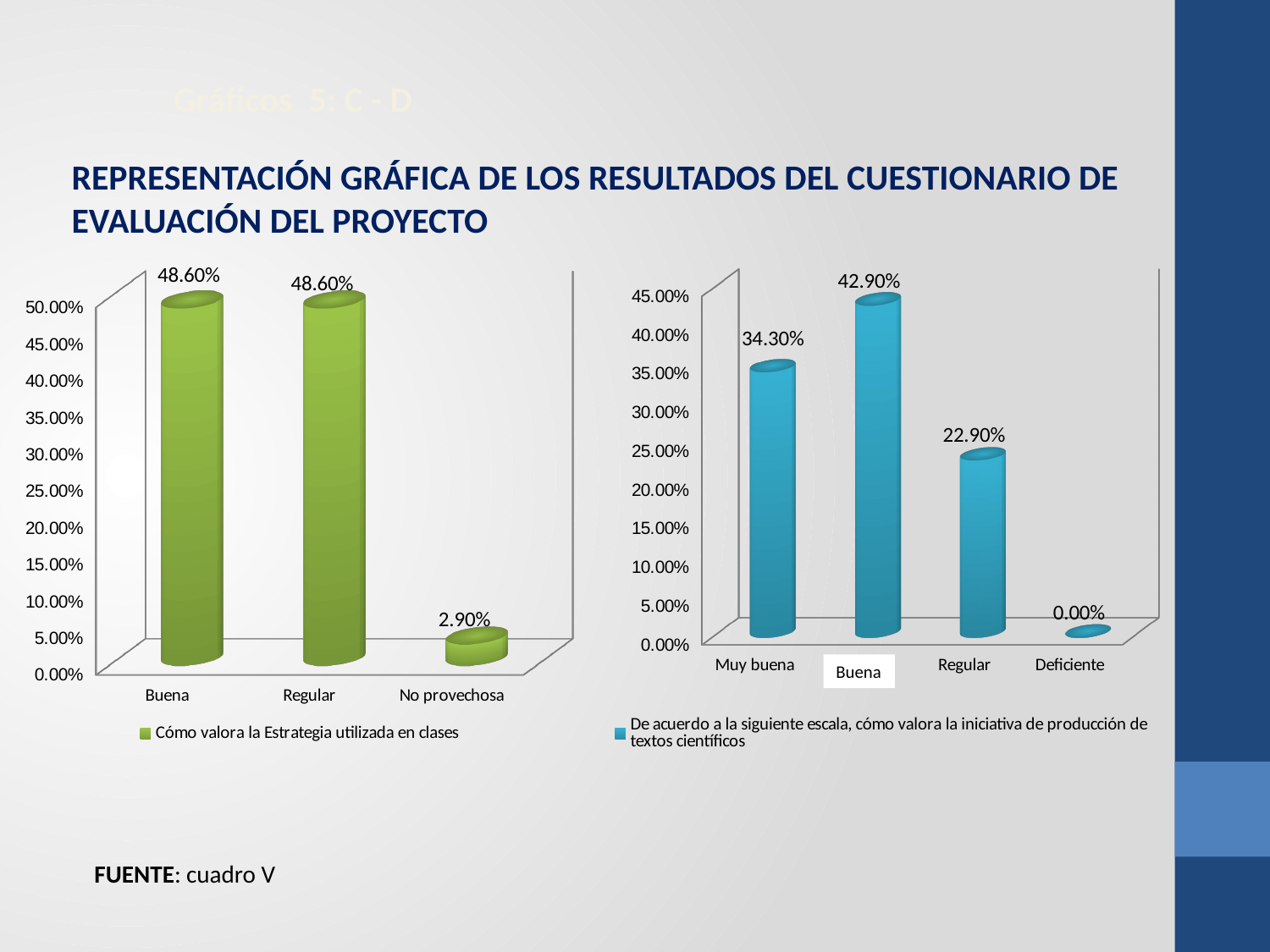
In the left chart, what is the value for No provechosa? 2.90% What kind of chart is the right chart? Bar chart In the left chart, how many categories are shown on the x axis? 3 In the right chart, what is the difference between the values for Buena and Regular? 20.00% In the right chart, what is the value for Deficiente? 0.00% In the right chart, which category has the highest value? Buena In the left chart, what is the difference between the values for Buena and No provechosa? 45.70% In the right chart, which is larger, the value for Muy buena or the value for Regular? Muy buena In the left chart, which category has the lowest value? No provechosa In the right chart, what is the value for Muy buena? 34.30% In the right chart, how many categories are shown on the x axis? 4 In the left chart, what is the value for Buena? 48.60%